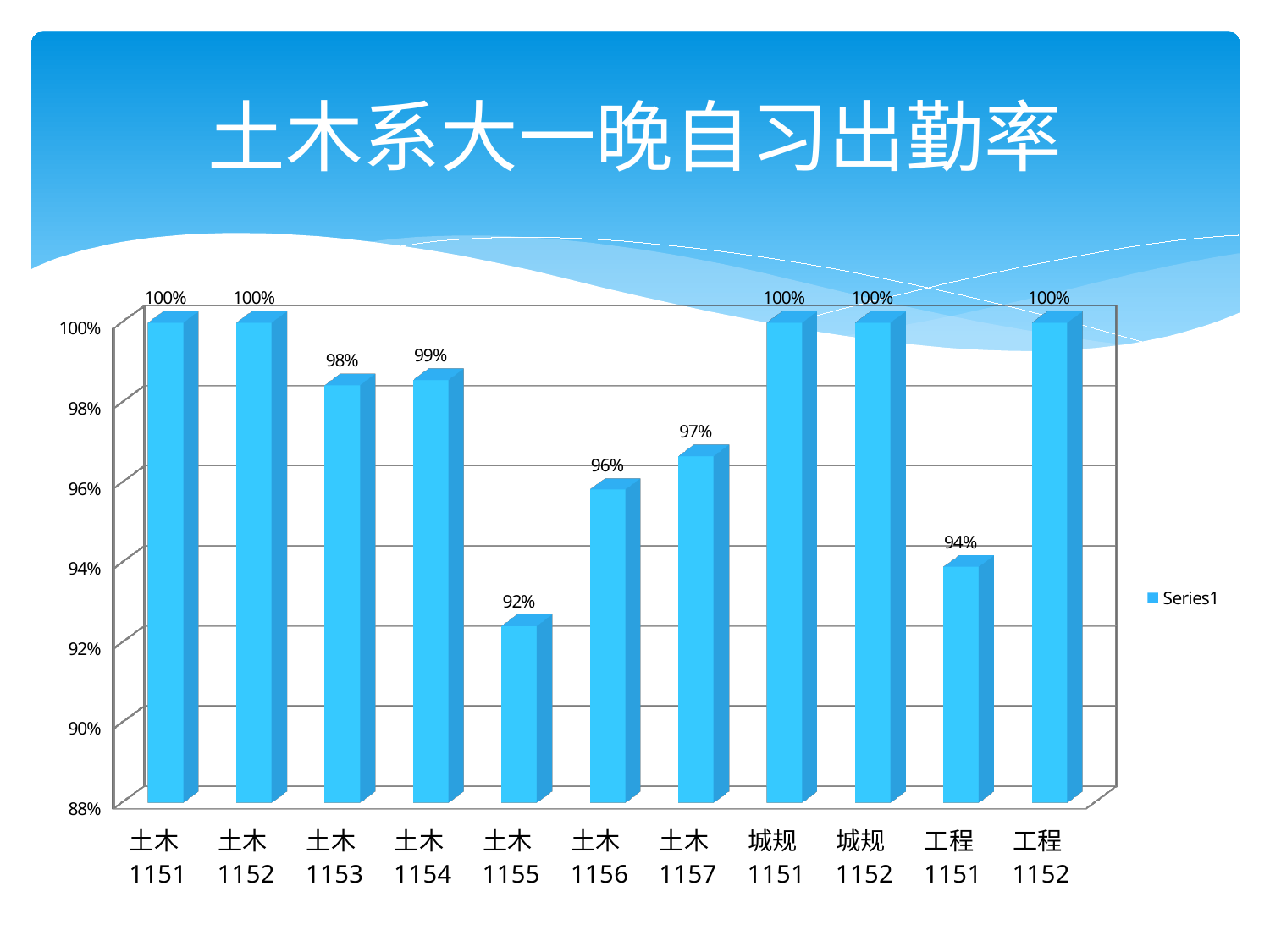
What is the difference between the attendance rates of 土木1154 and 土木1155? 7% How many series does the legend list? 1 Which has a higher attendance rate, 土木1156 or 工程1151? 土木1156 What is the attendance rate for 土木1157? 97% How many classes are shown on the x axis? 11 What is the attendance rate for 工程1151? 94% What is the title of the slide? 土木系大一晚自习出勤率 What kind of chart is shown on the slide? bar chart What is the attendance rate for 土木1153? 98% Which class has the lowest attendance rate? 土木1155 Is the value for 土木1157 greater or less than 96%? greater What is the attendance rate for 土木1155? 92%